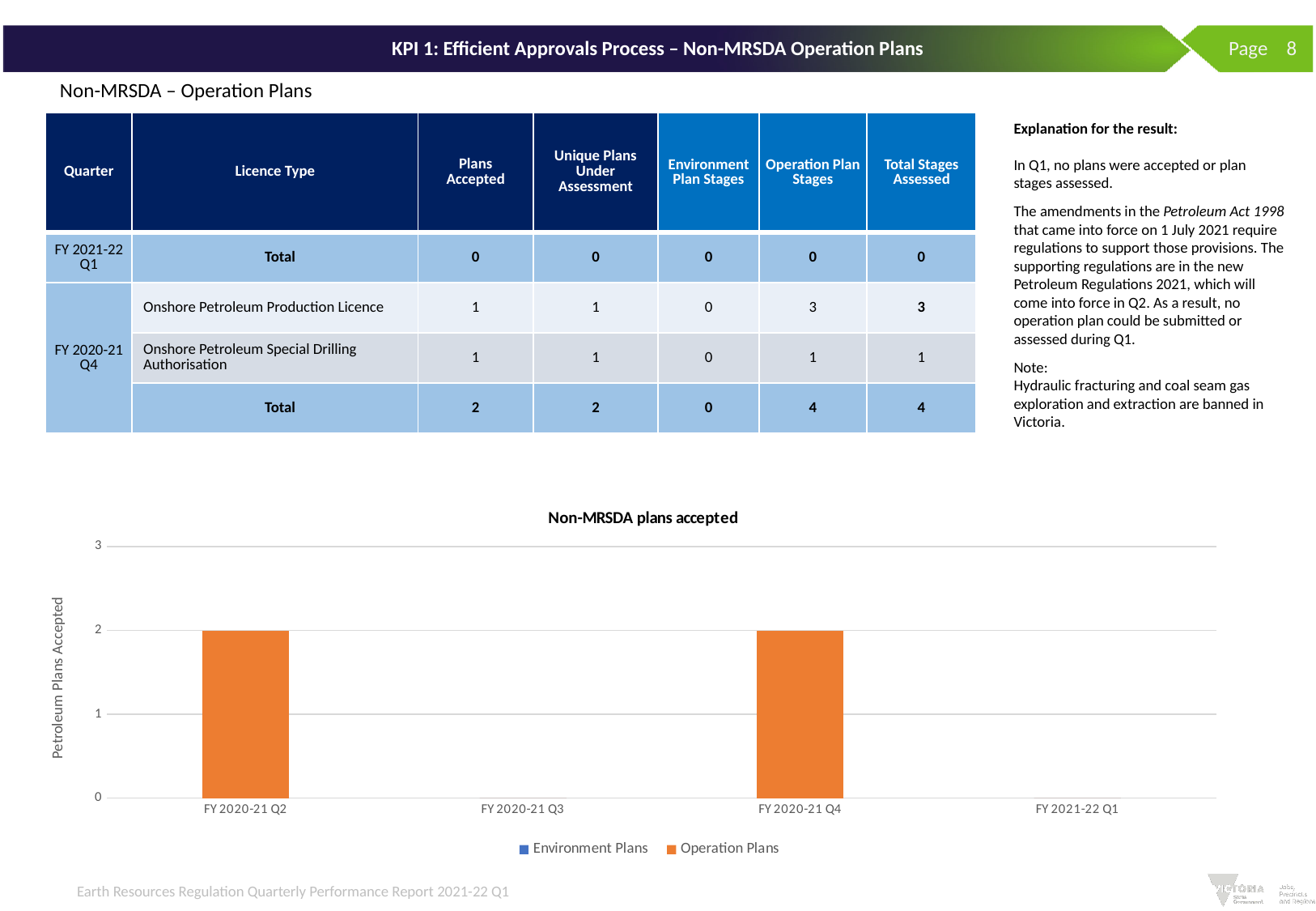
In the 'Non-MRSDA plans accepted' chart, what is the difference between Operation Plans in FY 2020-21 Q4 and FY 2021-22 Q1? 2 In the 'Non-MRSDA plans accepted' chart, what is the value for Operation Plans in FY 2020-21 Q4? 2 How many quarters are shown on the x axis of the 'Non-MRSDA plans accepted' chart? 4 In the 'Non-MRSDA plans accepted' chart, what is the value for Operation Plans in FY 2020-21 Q2? 2 What kind of chart is the 'Non-MRSDA plans accepted' chart? bar chart How many series does the legend of the 'Non-MRSDA plans accepted' chart list? 2 In the 'Non-MRSDA plans accepted' chart, which is larger for Operation Plans: FY 2020-21 Q2 or FY 2020-21 Q3? FY 2020-21 Q2 In the 'Non-MRSDA plans accepted' chart, is the value for Operation Plans in FY 2020-21 Q4 greater or less than 3? less In the 'Non-MRSDA plans accepted' chart, what is the value for Operation Plans in FY 2021-22 Q1? 0 In the 'Non-MRSDA plans accepted' chart, is the value for Operation Plans in FY 2020-21 Q2 greater or less than 1? greater What is the y-axis label of the 'Non-MRSDA plans accepted' chart? Petroleum Plans Accepted What is the title of the bar chart on the slide? Non-MRSDA plans accepted